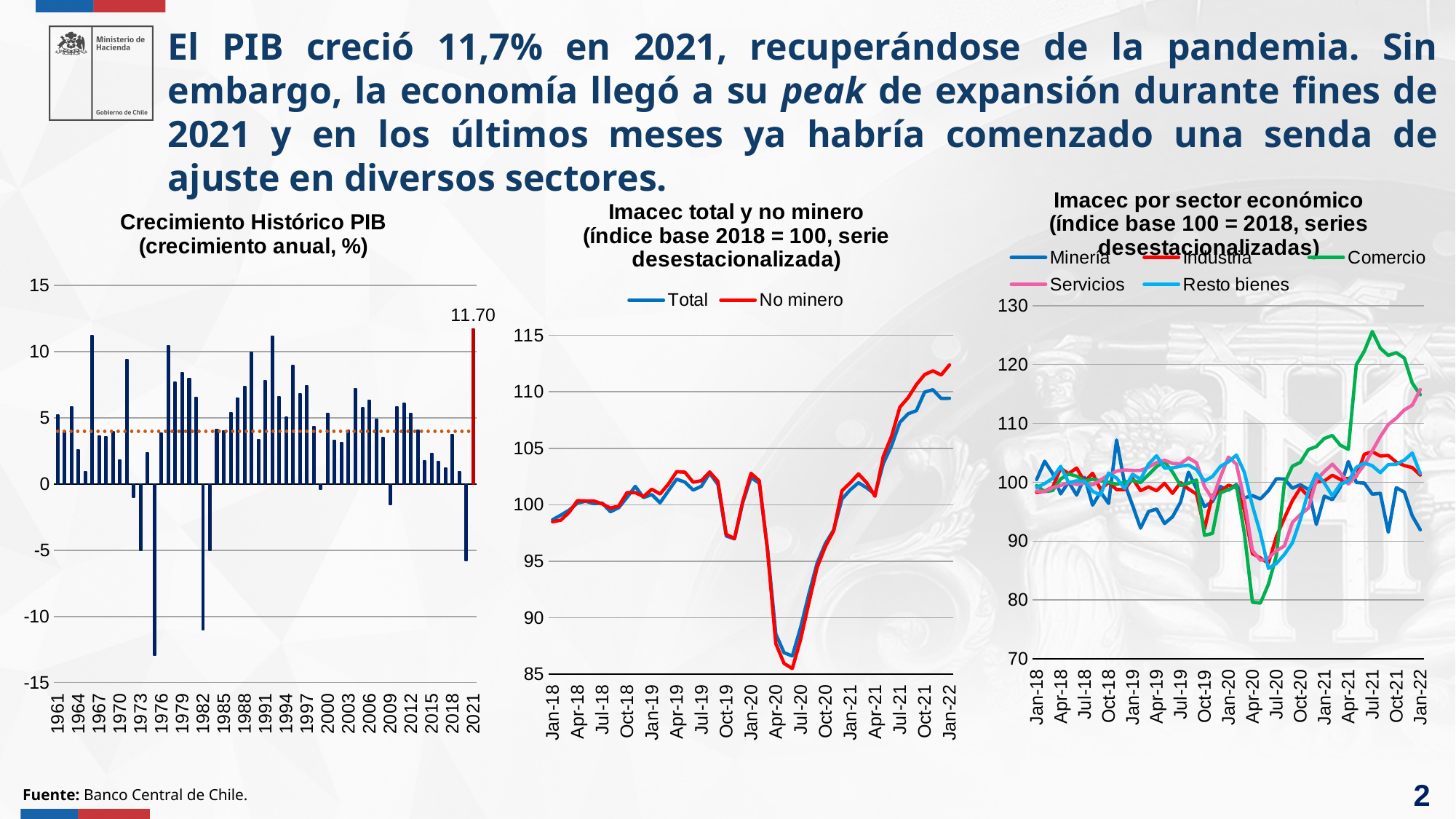
In the 'Imacec por sector económico' chart, at Jan-22 which series is higher, Comercio or Minería? Comercio In the 'Crecimiento Histórico PIB' chart, is the value for 2021 greater or less than 10? greater In the 'Imacec total y no minero' chart, is the value for No minero at Jan-22 greater or less than 110? greater In the 'Imacec total y no minero' chart, at Jan-22 which series is higher, Total or No minero? No minero In the 'Crecimiento Histórico PIB' chart, which year has the highest growth? 2021 In the 'Imacec por sector económico' chart, is the value for Comercio at Apr-20 greater or less than 85? less In the 'Imacec total y no minero' chart, what colour is the Total series line? blue How many series does the legend of the 'Imacec total y no minero' chart list? 2 In the 'Imacec por sector económico' chart, does the Minería series rise or fall between Jul-21 and Jan-22? fall What kind of chart is the 'Crecimiento Histórico PIB' chart? bar chart How many series does the legend of the 'Imacec por sector económico' chart list? 5 In the 'Crecimiento Histórico PIB' chart, what is the value for 2021? 11.70